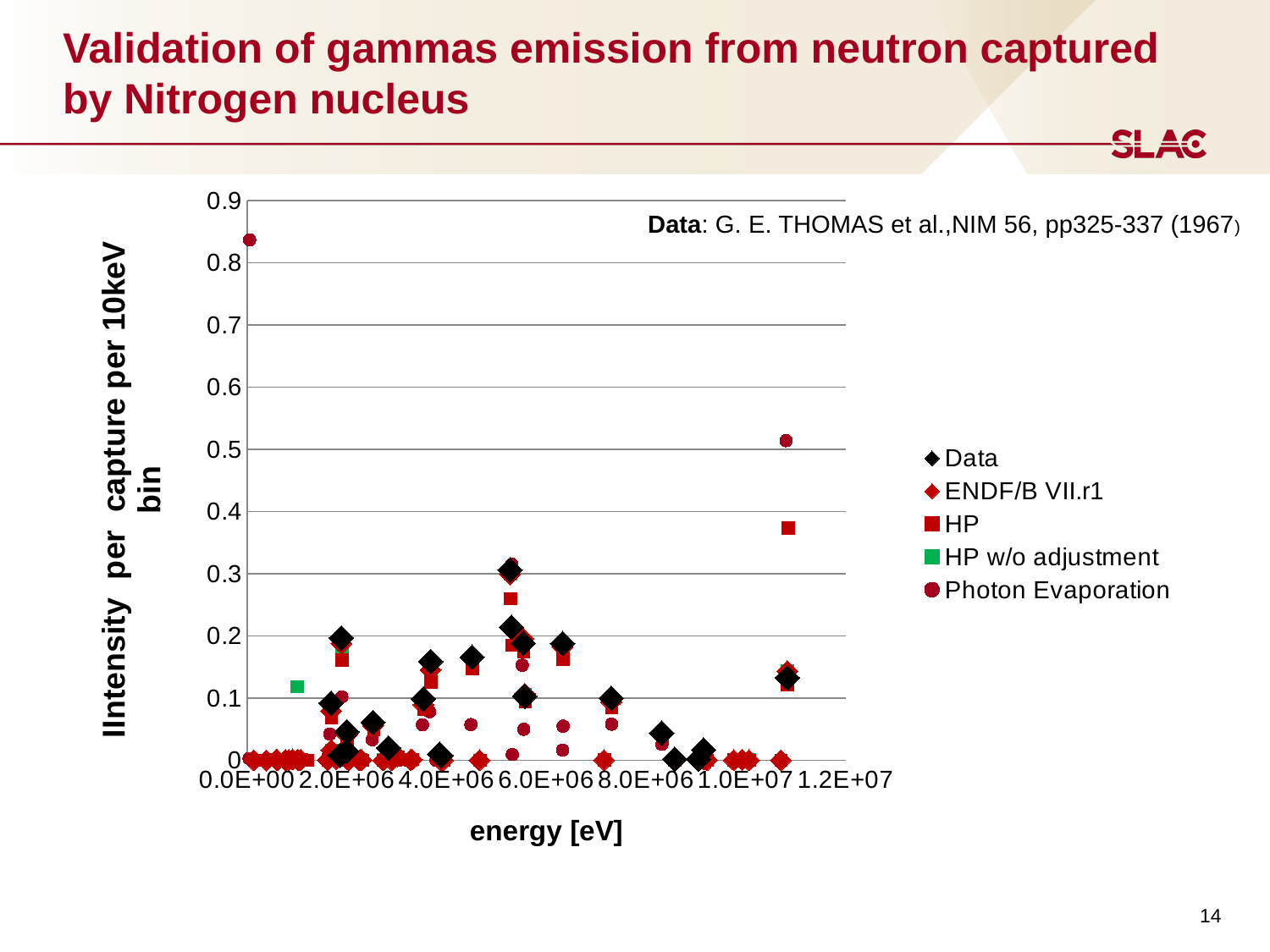
Near 1.1E+07 eV, which is larger: the Photon Evaporation value or the HP value? Photon Evaporation What is the title of the x axis? energy [eV] Is the Photon Evaporation value near 1.1E+07 eV greater or less than 0.4? greater Is the HP value near 1.1E+07 eV greater or less than 0.4? less What kind of chart is shown on the slide? scatter chart Which series is shown with a green square marker in the legend? HP w/o adjustment How many series does the legend list? 5 Which series has the highest plotted value on the chart? Photon Evaporation Is the HP value near 1.1E+07 eV greater or less than 0.3? greater